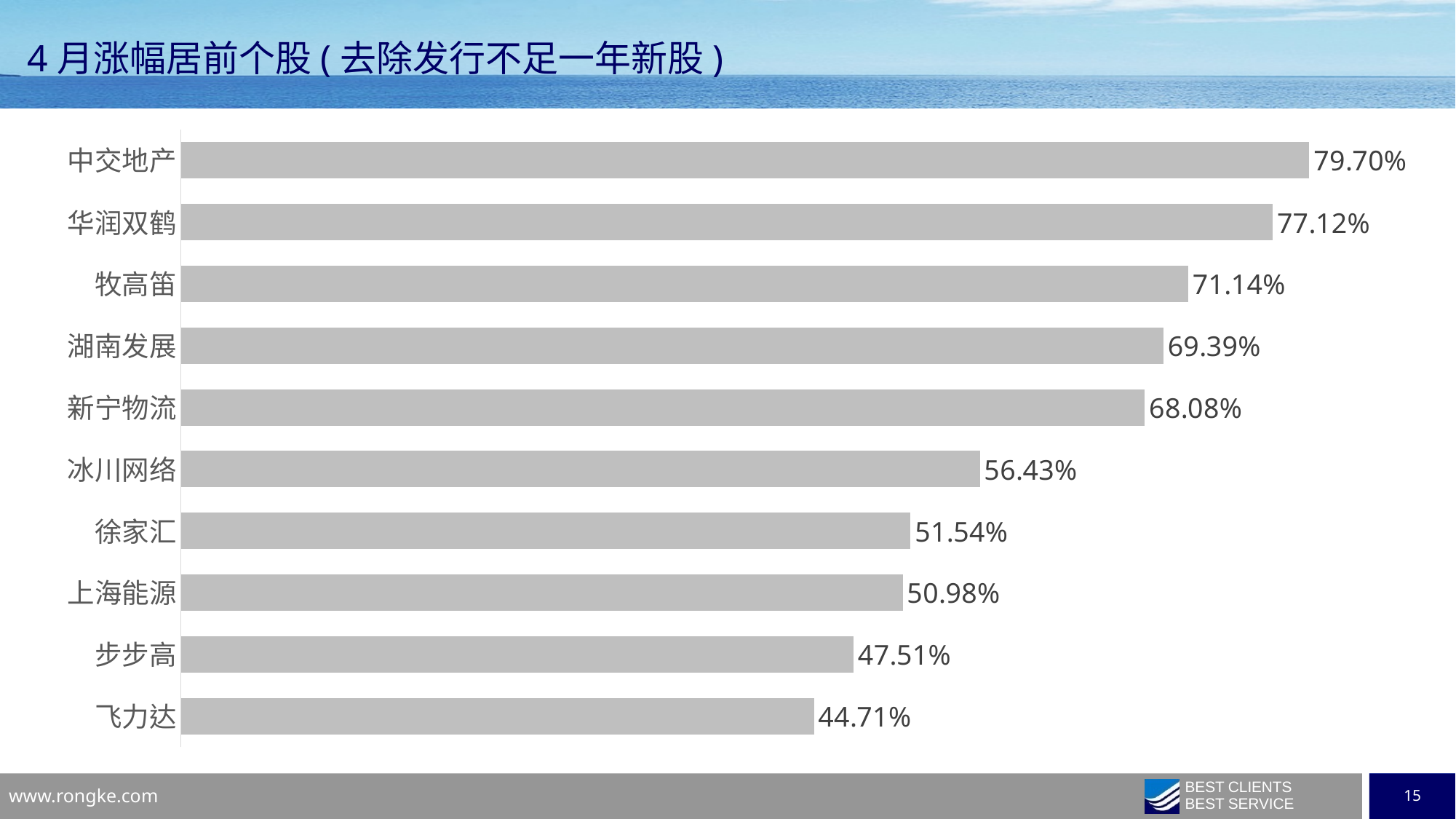
What is the title of the slide? 4月涨幅居前个股（去除发行不足一年新股） Which stock has the highest value on the chart? 中交地产 What is the difference between the values for 中交地产 and 华润双鹤? 2.58% What is the value for 中交地产? 79.70% What is the value for 牧高笛? 71.14% What is the difference between the values for 湖南发展 and 新宁物流? 1.31% Which stock has the lowest value on the chart? 飞力达 What kind of chart is shown on the slide? Bar chart Which is larger, the value for 徐家汇 or the value for 上海能源? 徐家汇 What is the value for 步步高? 47.51% What is the value for 冰川网络? 56.43% How many stocks are shown on the chart? 10